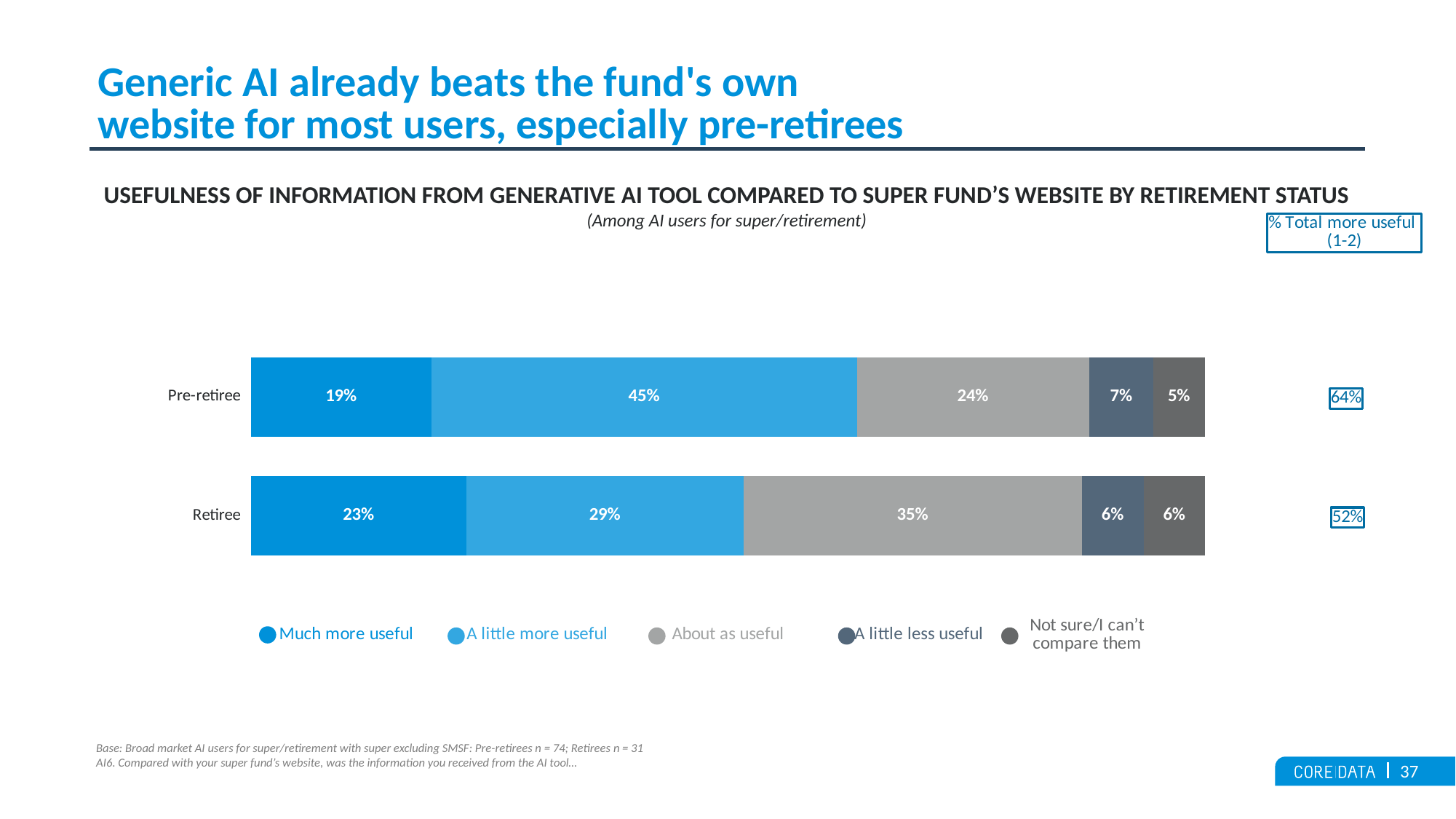
What percentage of pre-retirees said the AI tool was 'A little more useful' than the super fund's website? 45% How many response categories does the legend list? 5 What is the '% Total more useful (1-2)' figure for retirees? 52% What type of chart is shown on the slide? Stacked bar chart What percentage of retirees said the AI tool was 'About as useful' as the super fund's website? 35% What percentage of retirees said the AI tool was 'Much more useful'? 23% How many retirement status categories are shown in the chart? 2 What is the difference between the 'A little more useful' percentages for pre-retirees and retirees? 16 percentage points Which retirement status group has the higher '% Total more useful (1-2)' figure? Pre-retiree Which group has the larger 'About as useful' share, pre-retirees or retirees? Retiree What is the combined percentage of pre-retirees who said 'Much more useful' or 'A little more useful'? 64% Which legend category is shown in the darkest grey colour? Not sure/I can't compare them